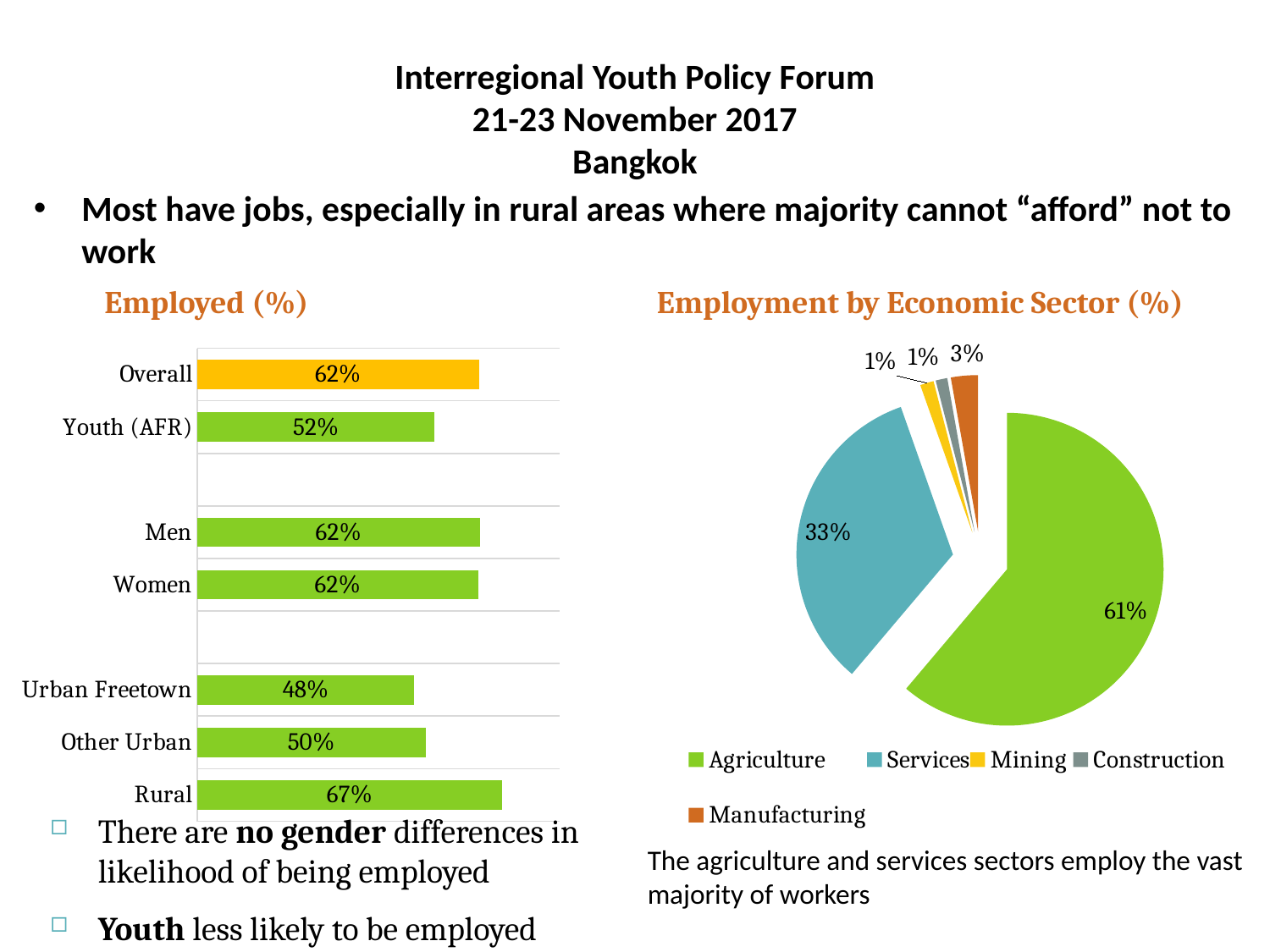
In the Employment by Economic Sector (%) chart, what is the value for Manufacturing? 3% In the Employed (%) chart, how many categories are plotted? 7 What kind of chart is the Employed (%) chart? bar chart In the Employed (%) chart, what is the difference between the values for Rural and Urban Freetown? 19% How many entries does the legend of the Employment by Economic Sector (%) chart list? 5 In the Employed (%) chart, is the value for Other Urban larger or smaller than the value for Overall? smaller In the Employed (%) chart, which category has the lowest value? Urban Freetown In the Employed (%) chart, which category has the highest value? Rural In the Employment by Economic Sector (%) chart, what share does Agriculture have? 61% In the Employed (%) chart, what is the value for Rural? 67% In the Employment by Economic Sector (%) chart, what is the value for Services? 33% In the Employed (%) chart, what is the value for Youth (AFR)? 52%